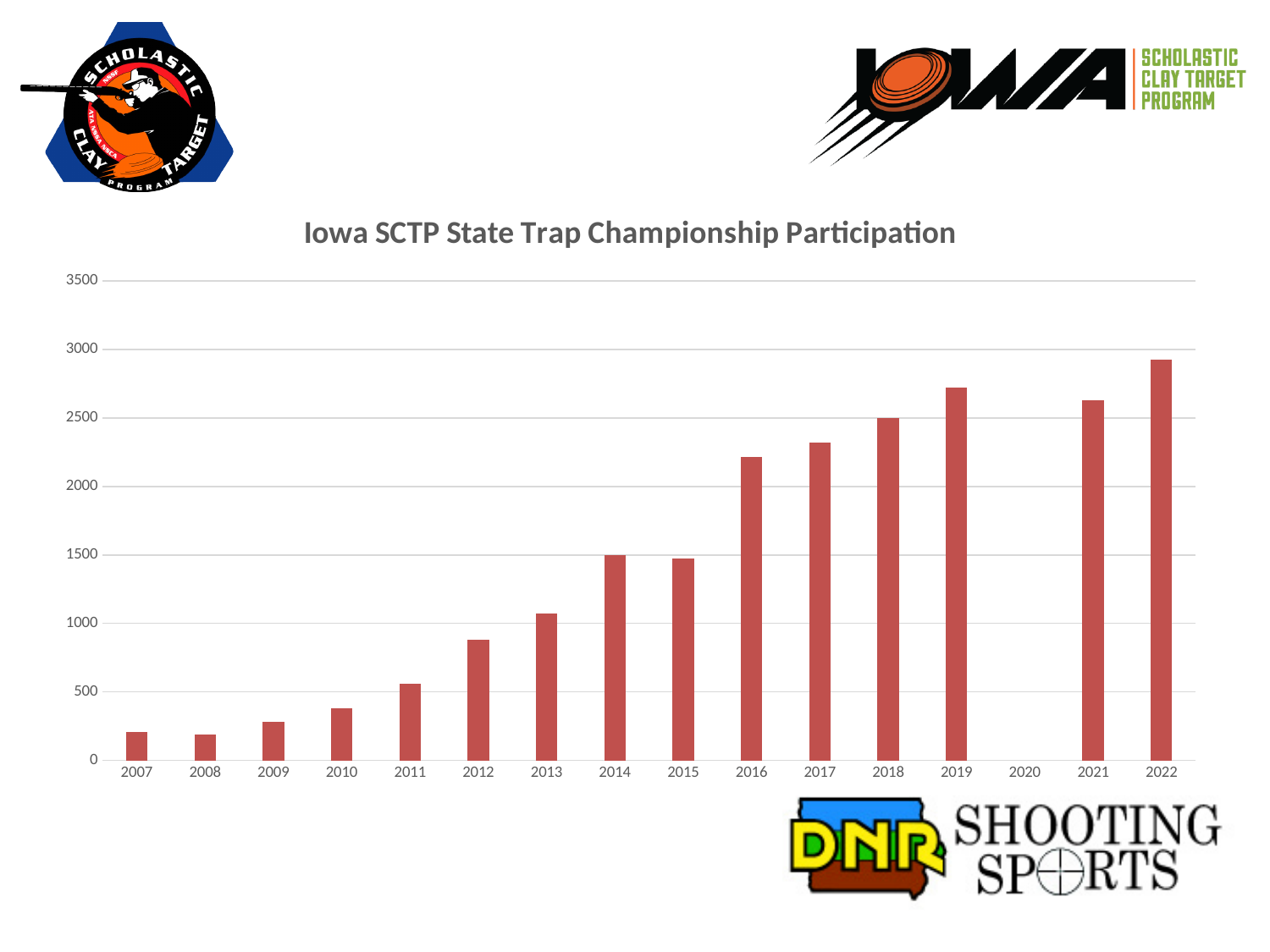
Is the value for 2016 greater or less than 2000? greater Is the value for 2010 greater or less than 500? less Is the value for 2022 greater or less than 3000? less Overall, do the participation values rise or fall from 2007 to 2022? Rise Which year on the x axis has no bar shown? 2020 How many years are labelled on the x axis of the chart? 16 Which year has the highest participation bar? 2022 What type of chart is shown on the slide? Bar chart What is the title of the chart? Iowa SCTP State Trap Championship Participation Which year has the larger value, 2019 or 2021? 2019